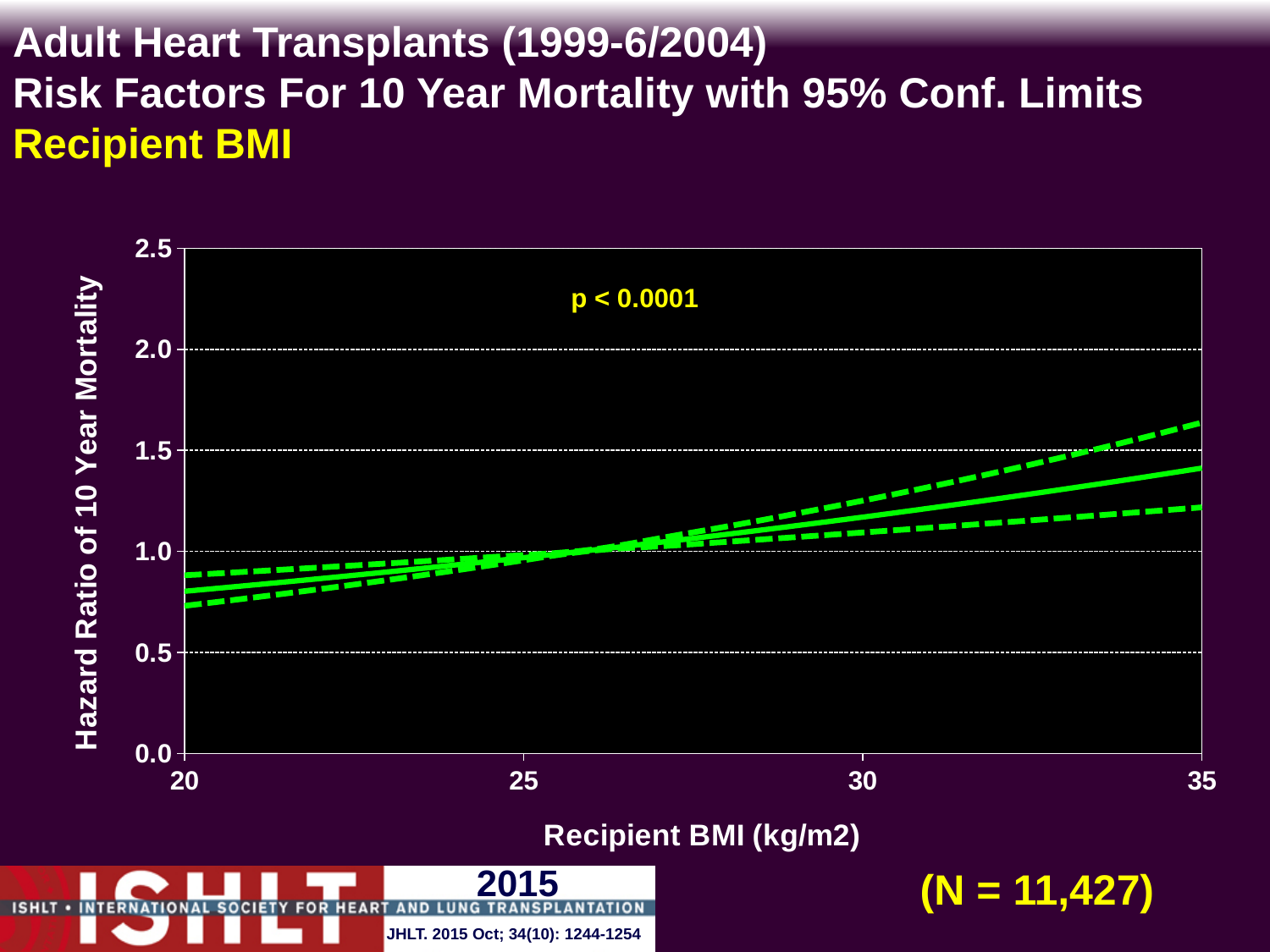
Is the hazard ratio for a recipient BMI of 35 greater or less than 1.0? greater What p-value is printed on the chart? p < 0.0001 What kind of chart is shown on the slide? line chart Is the lower 95% confidence limit at a recipient BMI of 35 greater or less than 1.5? less How many lines are plotted on the chart? 3 What is the label of the x axis? Recipient BMI (kg/m2) Is the hazard ratio for a recipient BMI of 20 greater or less than 0.5? greater Does the hazard ratio of 10 year mortality rise or fall as recipient BMI increases from 20 to 35? rise